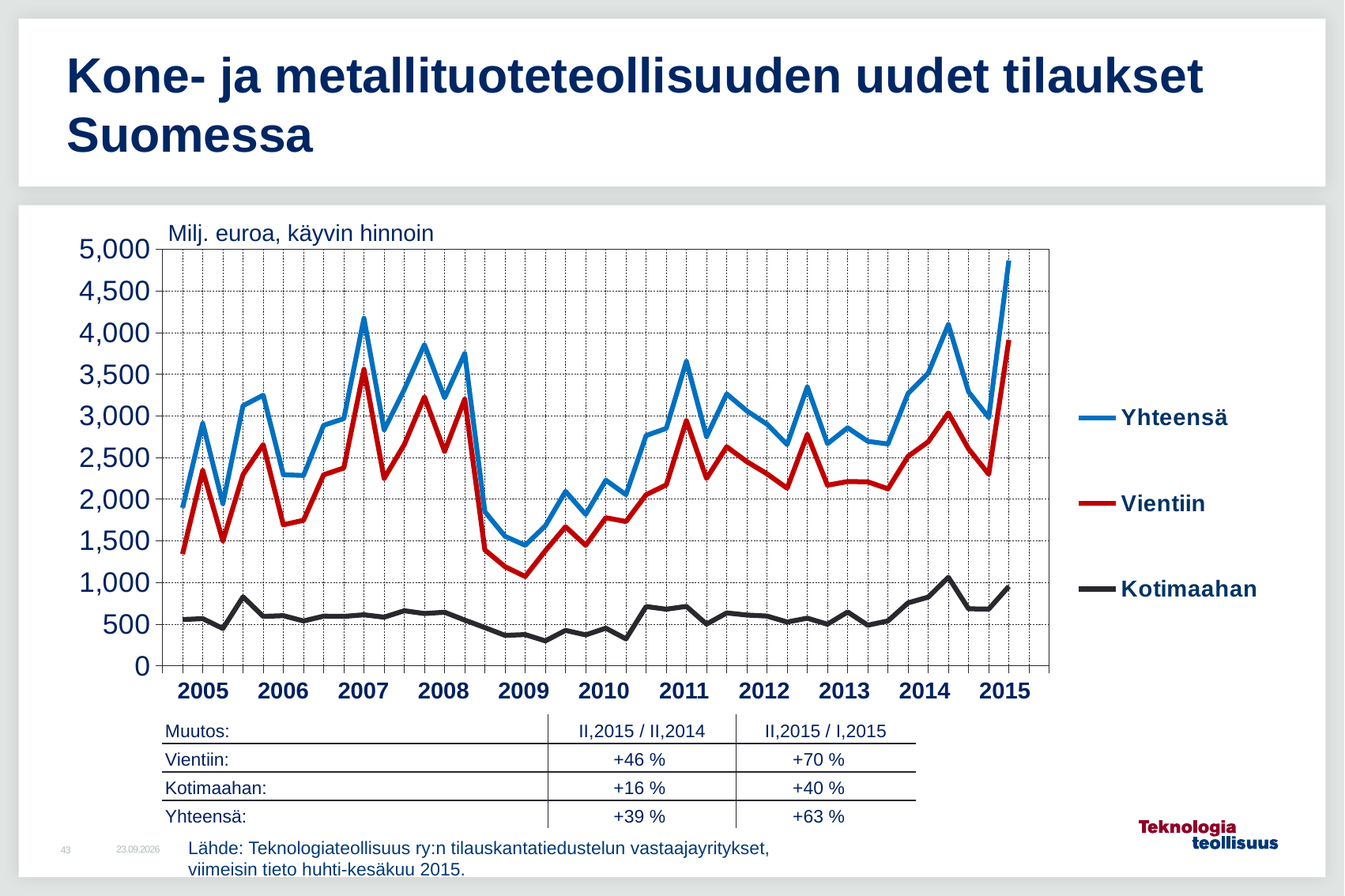
Which series has the highest values throughout the chart? Yhteensä What unit is stated above the chart's y axis? Milj. euroa, käyvin hinnoin Which series is larger in 2012, Vientiin or Kotimaahan? Vientiin What are the three series named in the chart legend? Yhteensä, Vientiin, Kotimaahan Is the value of Yhteensä at the last point in 2015 greater or less than 4,500? greater How many series does the chart legend list? 3 How many years are labelled on the chart's x axis? 11 Does the Yhteensä line rise or fall from 2008 to 2009? fall Is the value of Vientiin at the last point in 2015 greater or less than 3,500? greater What kind of chart is shown on the slide? line chart Which series has the lowest values throughout the chart? Kotimaahan Is the lowest value of Vientiin in 2009 greater or less than 1,500? less